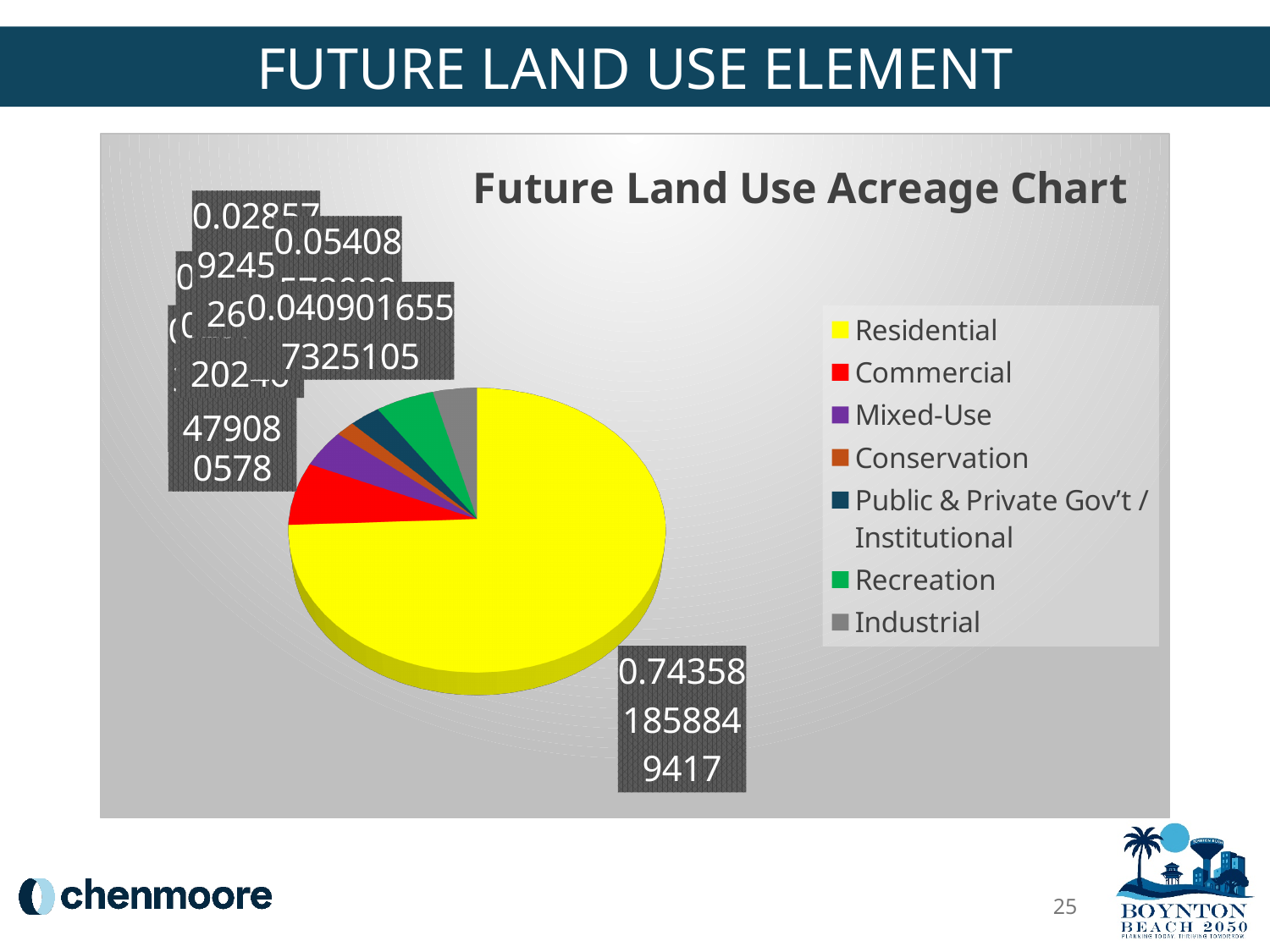
Which is larger, the Commercial slice or the Mixed-Use slice? Commercial What is the title of the chart? Future Land Use Acreage Chart Is the Residential share of the pie greater or less than 0.5? greater How many categories does the legend of the pie chart list? 7 What colour is used for the Residential category in the pie chart? yellow Which is larger, the Residential slice or the Commercial slice? Residential What is the data label shown for the Residential slice? 0.743581858849417 Is the Commercial share of the pie greater or less than 0.25? less Which category has the largest slice of the pie? Residential What kind of chart is shown on the slide? pie chart Which is larger, the Commercial slice or the Industrial slice? Commercial